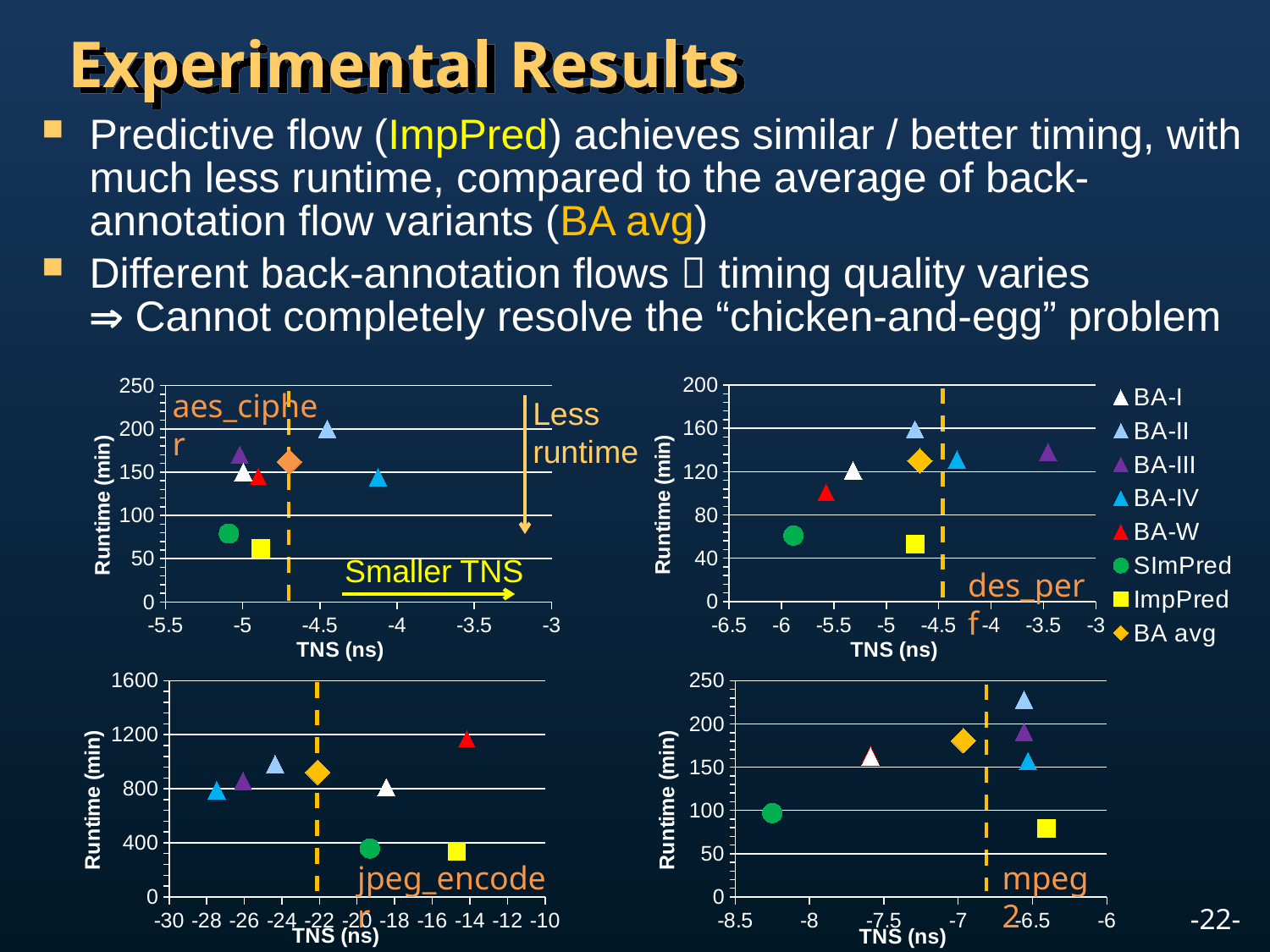
In the jpeg_encode chart, which series has the highest runtime? BA-W What is the label of the y axis on the charts? Runtime (min) In the aes_cipher chart, is the runtime for ImpPred greater or less than 100? less How many charts are shown on the slide? 4 How many series does the legend list? 8 In the mpeg2 chart, which has the higher runtime, SImPred or ImpPred? SImPred In the des_perf chart, is the runtime for BA-II greater or less than 120? greater In the des_perf chart, which series has the lowest runtime? ImpPred In the aes_cipher chart, which series has the highest runtime? BA-II In the jpeg_encode chart, is the runtime for ImpPred greater or less than 800? less What kind of chart is the aes_cipher chart? scatter chart